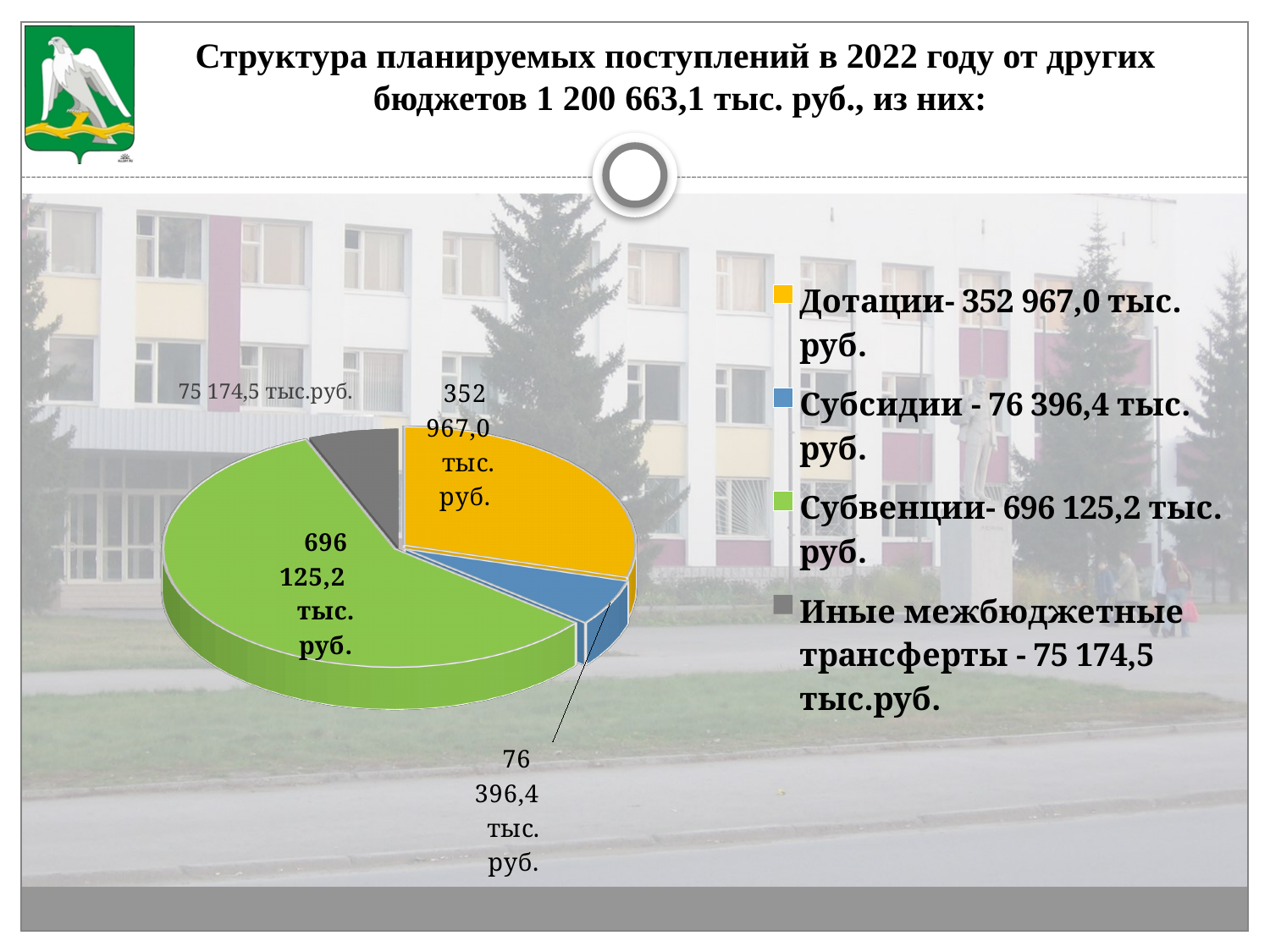
What is the difference between the values for Субсидии and Иные межбюджетные трансферты? 1 221,9 тыс. руб. What colour is the Субвенции slice in the pie chart? Green Which category has the smallest value in the pie chart? Иные межбюджетные трансферты What is the value for Субвенции in the pie chart? 696 125,2 тыс. руб. Which is larger, the value for Дотации or the value for Субсидии? Дотации What is the value for Дотации in the pie chart? 352 967,0 тыс. руб. What kind of chart is shown on the slide? Pie chart What is the value for Субсидии in the pie chart? 76 396,4 тыс. руб. What is the value for Иные межбюджетные трансферты in the pie chart? 75 174,5 тыс.руб. What is the difference between the values for Субвенции and Дотации? 343 158,2 тыс. руб. Which category has the largest slice of the pie chart? Субвенции How many categories does the pie chart show? 4